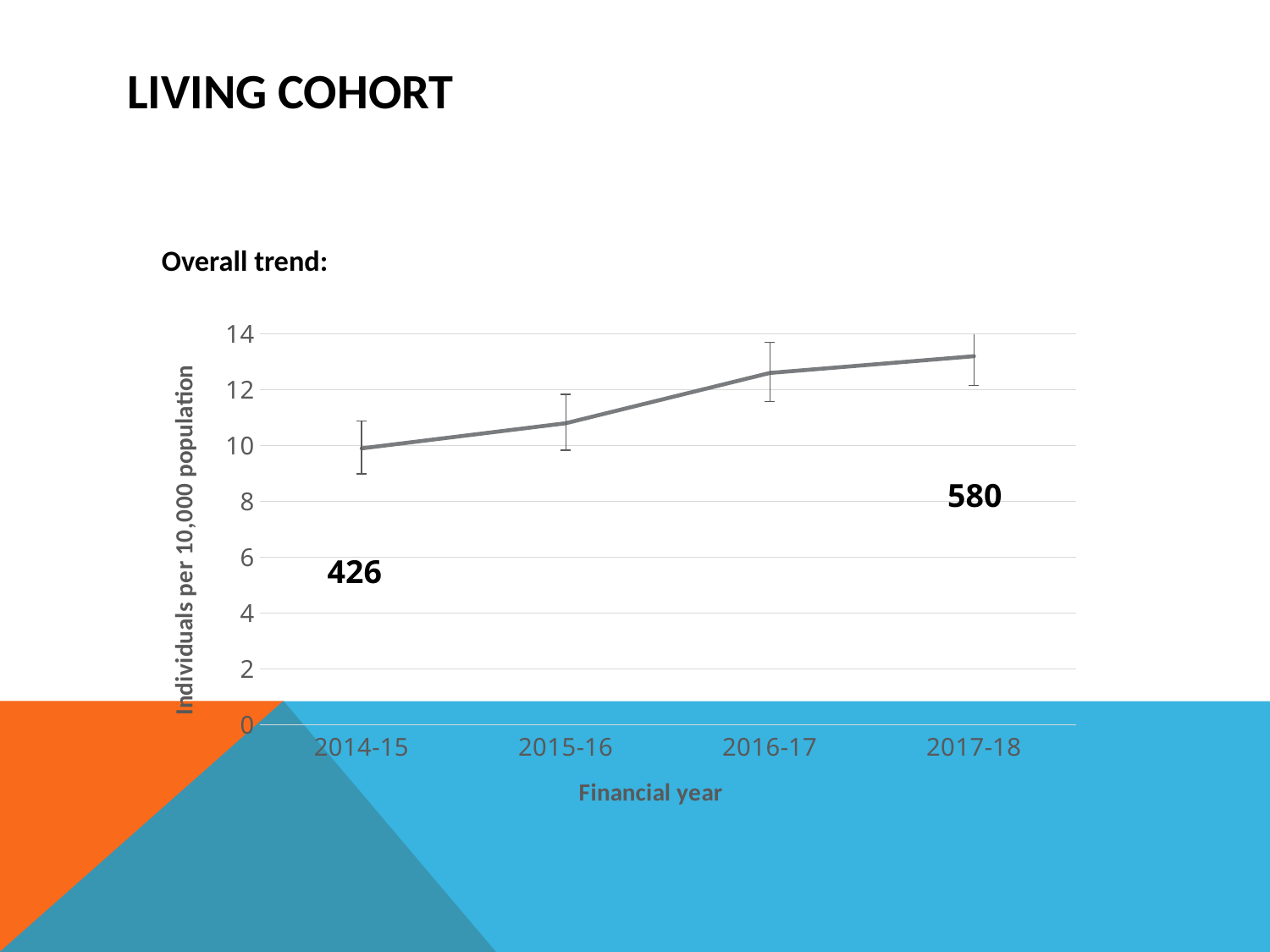
What is the title of the y axis? Individuals per 10,000 population Which financial year has the lowest value? 2014-15 Is the value for 2014-15 greater or less than 8? greater Which is larger, the value for 2014-15 or the value for 2017-18? 2017-18 What is the title of the x axis? Financial year How many financial years are plotted on the x axis? 4 Is the value for 2015-16 greater or less than 12? less Which financial year has the highest value? 2017-18 What kind of chart is shown on the slide? line chart Do the values rise or fall from 2014-15 to 2017-18? rise Which is larger, the value for 2016-17 or the value for 2015-16? 2016-17 Is the value for 2017-18 greater or less than 12? greater